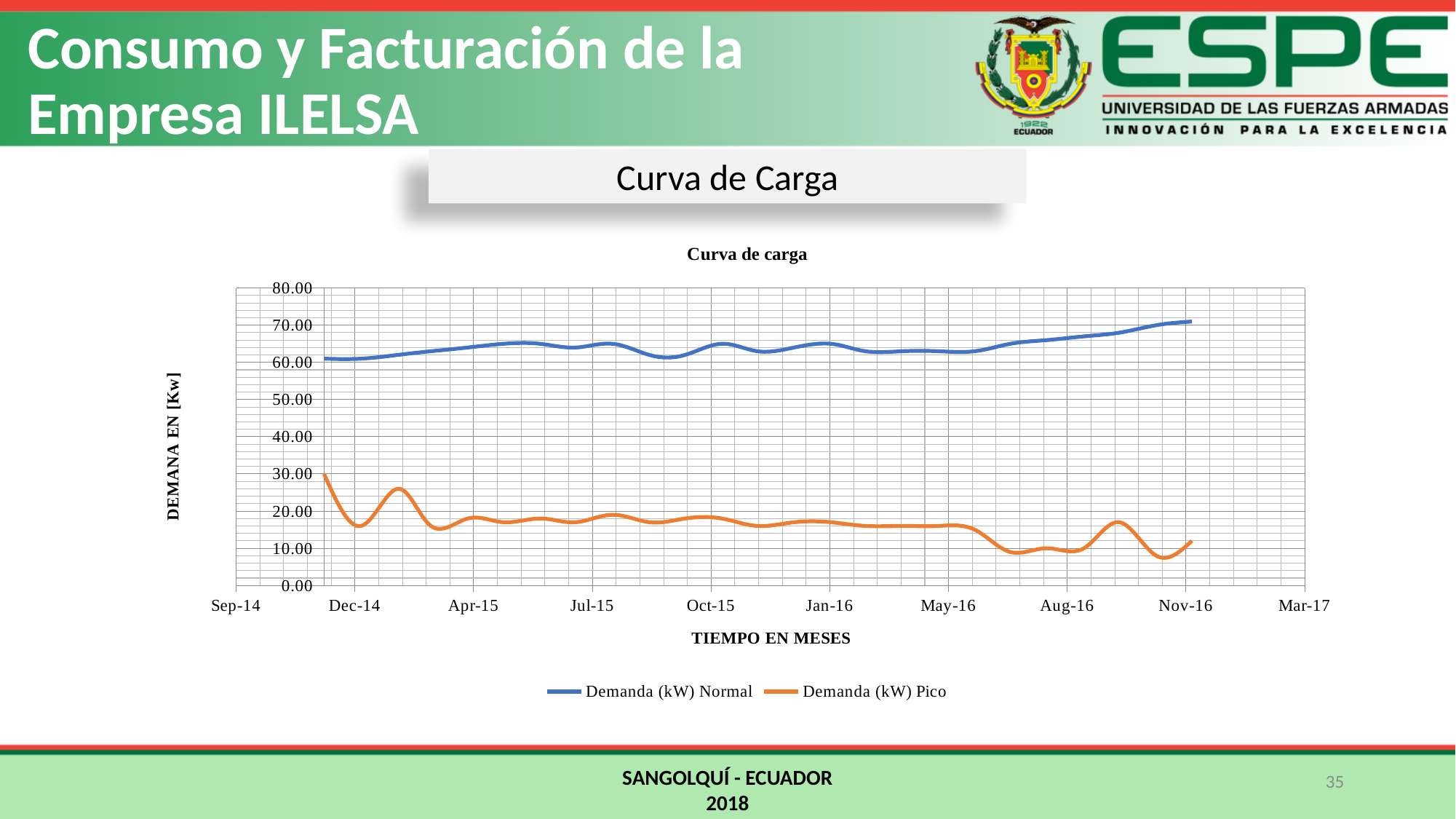
Is the value for Demanda (kW) Pico at Nov-16 greater or less than 20? less Is the value for Demanda (kW) Normal at Jul-15 greater or less than 60? greater What kind of chart is shown on the slide? line chart Is the value for Demanda (kW) Pico at Aug-16 greater or less than 20? less What is the label of the vertical axis of the chart? DEMANA EN [Kw] Does the Demanda (kW) Normal series generally rise or fall from Dec-14 to Nov-16? rise Which series has the larger value at Oct-15, Demanda (kW) Normal or Demanda (kW) Pico? Demanda (kW) Normal How many series does the legend of the chart list? 2 Does the Demanda (kW) Pico series generally rise or fall from Dec-14 to Nov-16? fall What is the title of the chart? Curva de carga